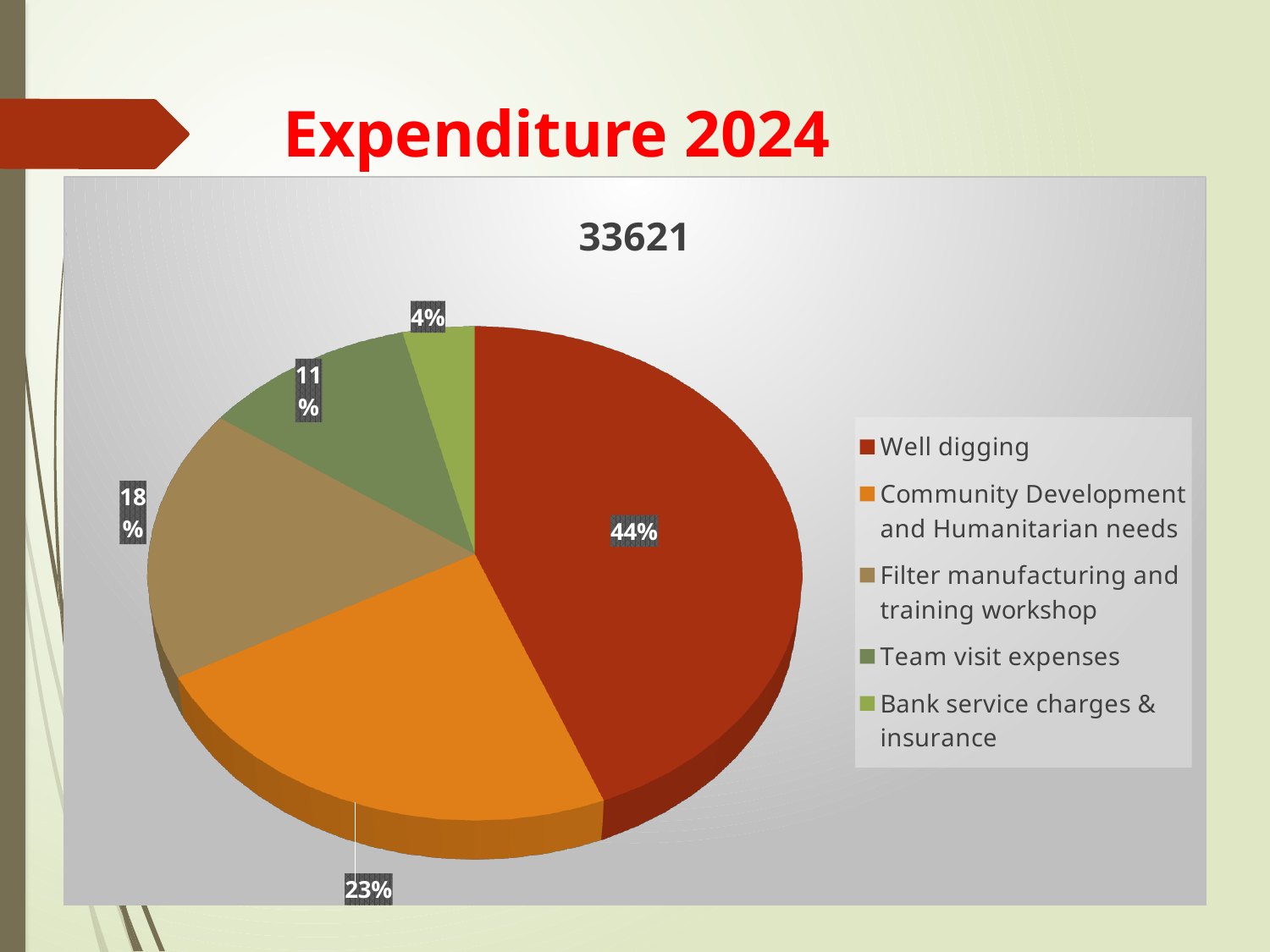
Which category has the smallest slice of the pie? Bank service charges & insurance What share of the pie does Bank service charges & insurance take? 4% What share of the pie does Community Development and Humanitarian needs take? 23% How many categories does the legend list? 5 What is the title of the chart? 33621 What share of the pie does Well digging take? 44% Which category has the largest slice of the pie? Well digging Which is larger, the share for Filter manufacturing and training workshop or the share for Team visit expenses? Filter manufacturing and training workshop What kind of chart is shown on the slide? pie chart What is the difference in percentage points between Well digging and Community Development and Humanitarian needs? 21